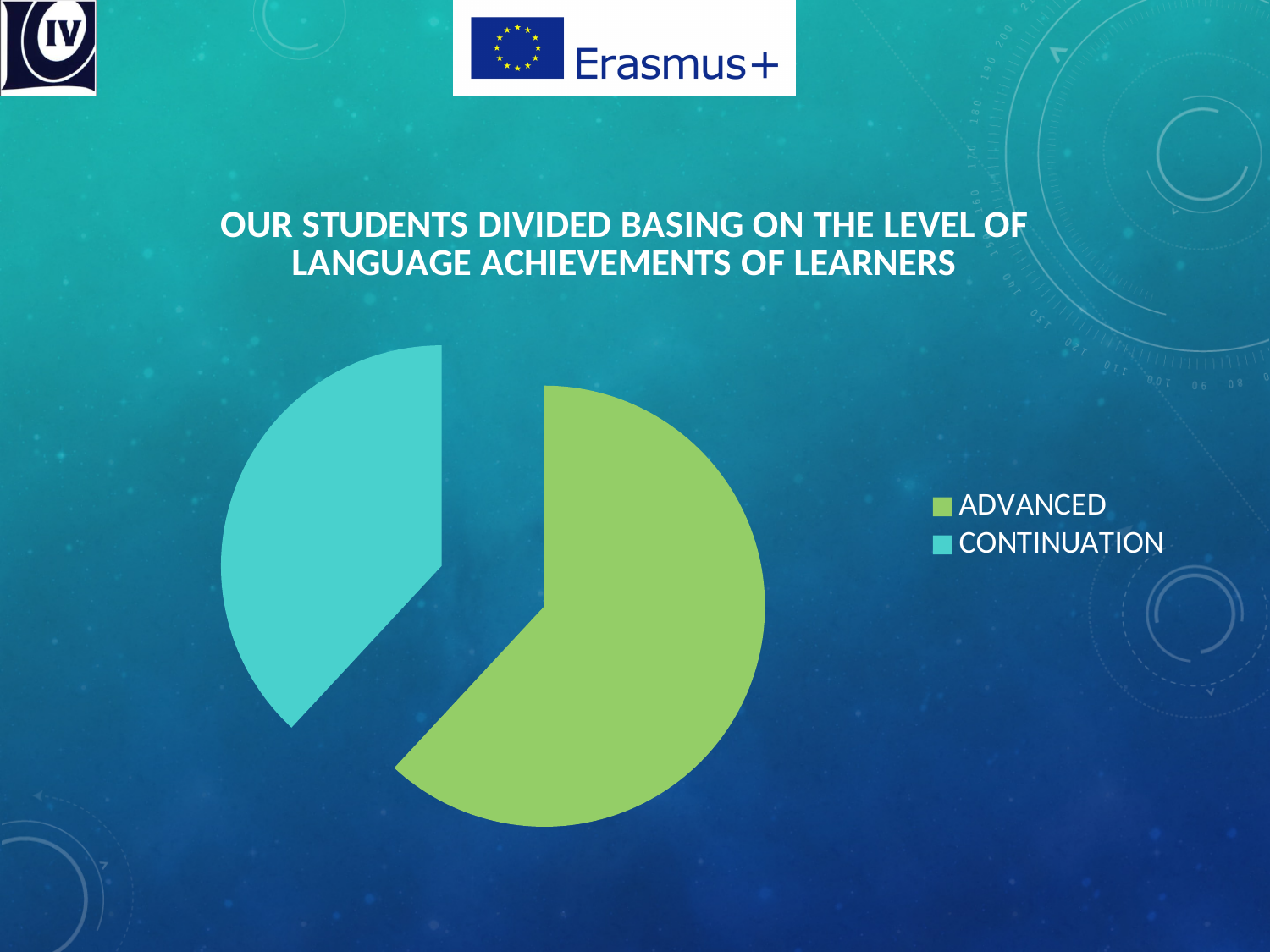
What is the title of the chart on the slide? OUR STUDENTS DIVIDED BASING ON THE LEVEL OF LANGUAGE ACHIEVEMENTS OF LEARNERS How many slices does the pie chart have? 2 How many entries does the legend of the pie chart list? 2 What kind of chart is shown on the slide? pie chart Which category has the largest slice of the pie chart? ADVANCED Does the ADVANCED slice take up more or less than half of the pie? more What colour is the CONTINUATION slice in the pie chart? teal (light blue) Does the CONTINUATION slice take up more or less than half of the pie? less Which category has the smallest slice of the pie chart? CONTINUATION Which slice is larger, ADVANCED or CONTINUATION? ADVANCED